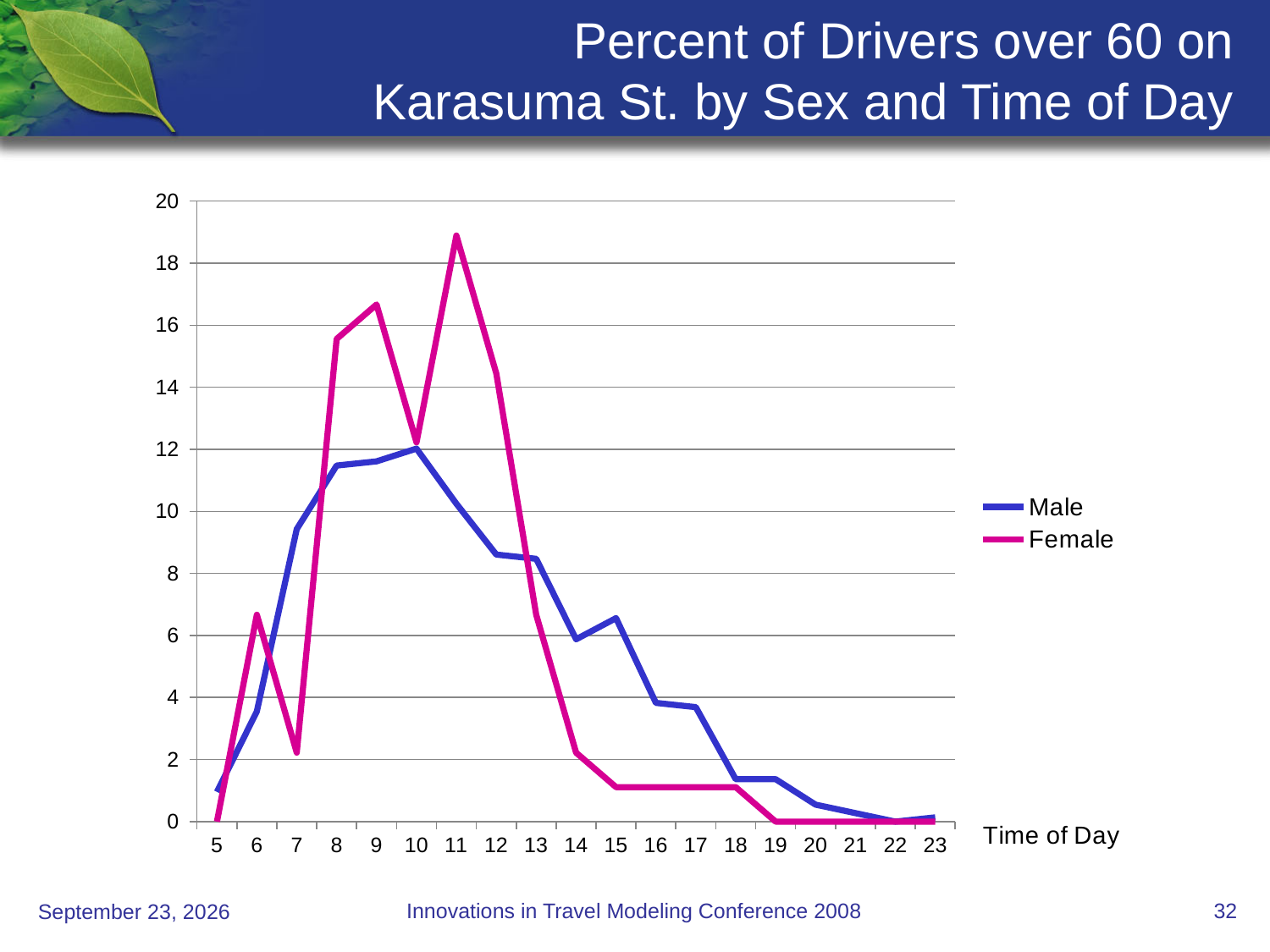
At 9, which series has the larger value, Male or Female? Female At 13, which series has the larger value, Male or Female? Male What kind of chart is shown on the slide? line chart At which time of day does the Female series reach its highest value? 11 Is the value for Male at 8 greater or less than 10? greater Is the value for Female at 7 greater or less than 4? less At which time of day does the Male series reach its highest value? 10 How many time-of-day points are plotted along the x axis? 19 How many series does the legend list? 2 Is the value for Female at 11 greater or less than 18? greater Which colour is used for the Female series? magenta (pink) Does the Male series rise or fall from 10 to 23? fall